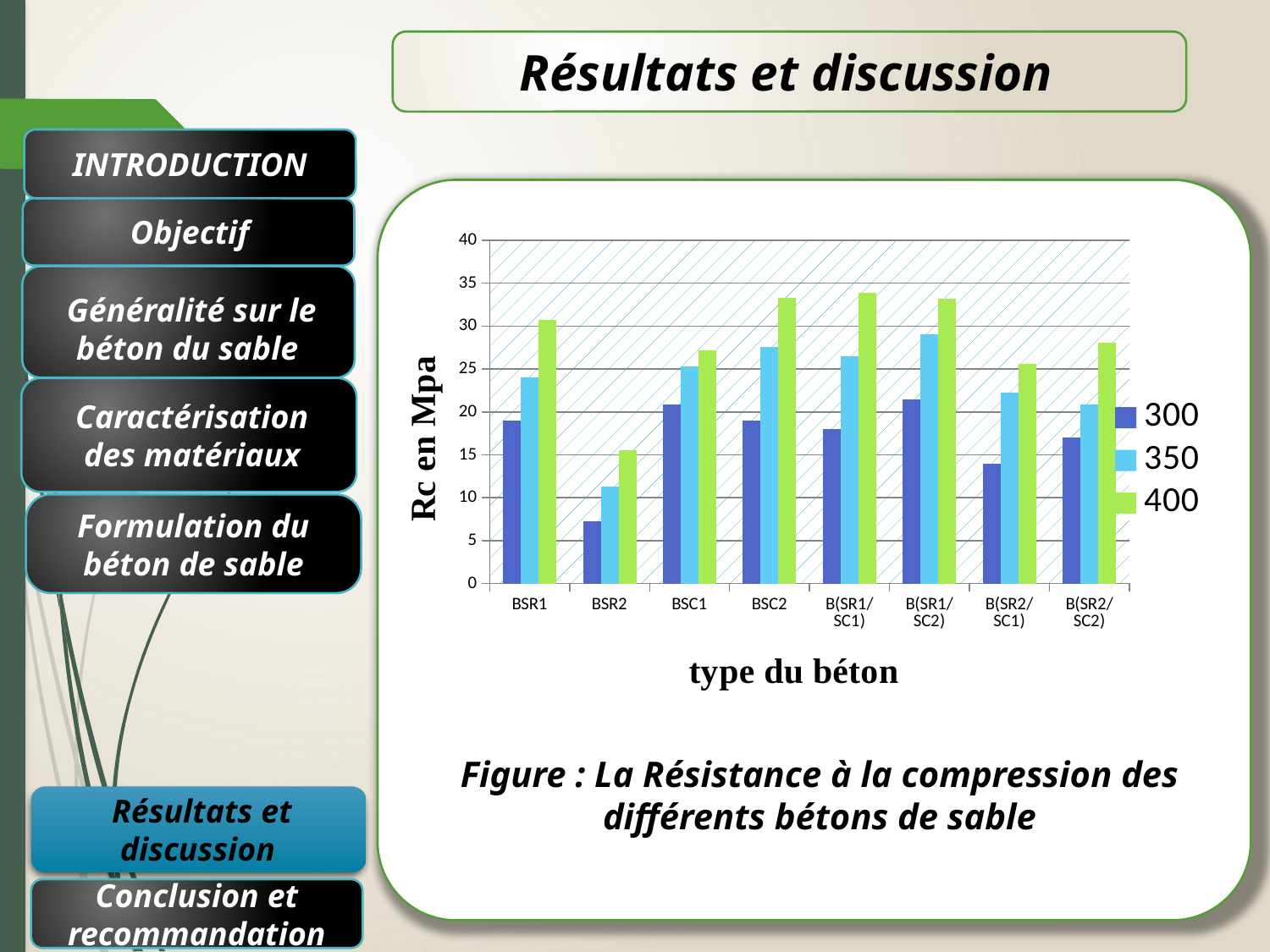
What is the label of the y axis? Rc en Mpa How many concrete types (categories) are shown on the x axis? 8 Is the value for B(SR2/SC1) in the 300 series greater or less than 15? less Which concrete type has the lowest value for the 400 series? BSR2 Which concrete type has the lowest value for the 300 series? BSR2 Which concrete type has the highest value for the 350 series? B(SR1/SC2) Which is larger for the 300 series: B(SR2/SC1) or B(SR2/SC2)? B(SR2/SC2) How many series does the legend list? 3 What kind of chart is shown on the slide? bar chart Which is larger for the 400 series: BSR1 or BSC1? BSR1 Is the value for BSR2 in the 400 series greater or less than 20? less